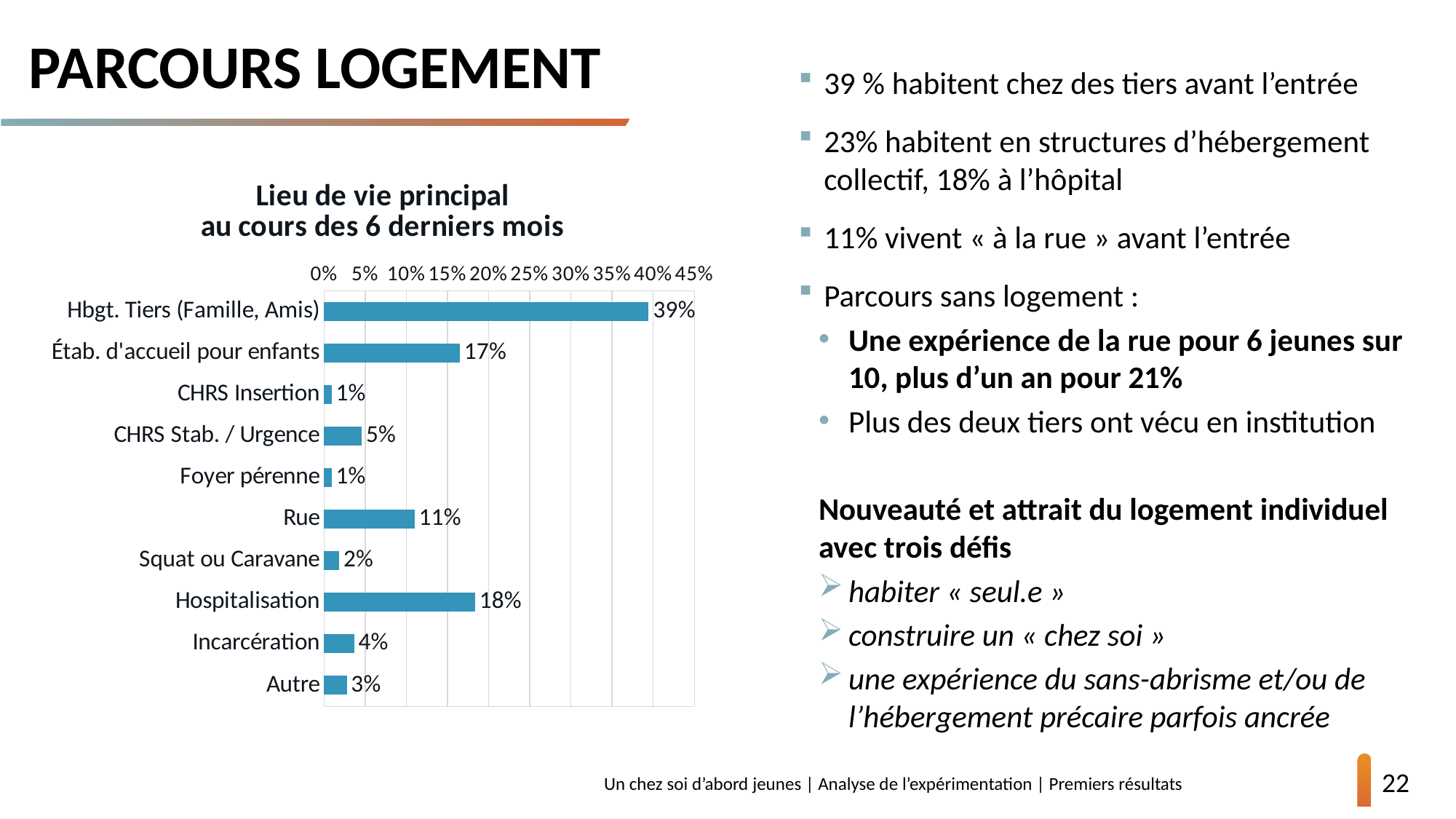
How many categories are shown in the chart? 10 What is the difference between Hbgt. Tiers (Famille, Amis) and Hospitalisation? 21% What is the value for Étab. d'accueil pour enfants? 17% What is the value for Autre? 3% What is the value for Rue? 11% Which category has the highest value? Hbgt. Tiers (Famille, Amis) What kind of chart is shown on the slide? Bar chart What is the title of the chart? Lieu de vie principal au cours des 6 derniers mois What is the difference between Rue and Squat ou Caravane? 9% What is the value for Hospitalisation? 18% Which is larger, CHRS Stab. / Urgence or Incarcération? CHRS Stab. / Urgence Is the value for Étab. d'accueil pour enfants greater or less than 15%? greater